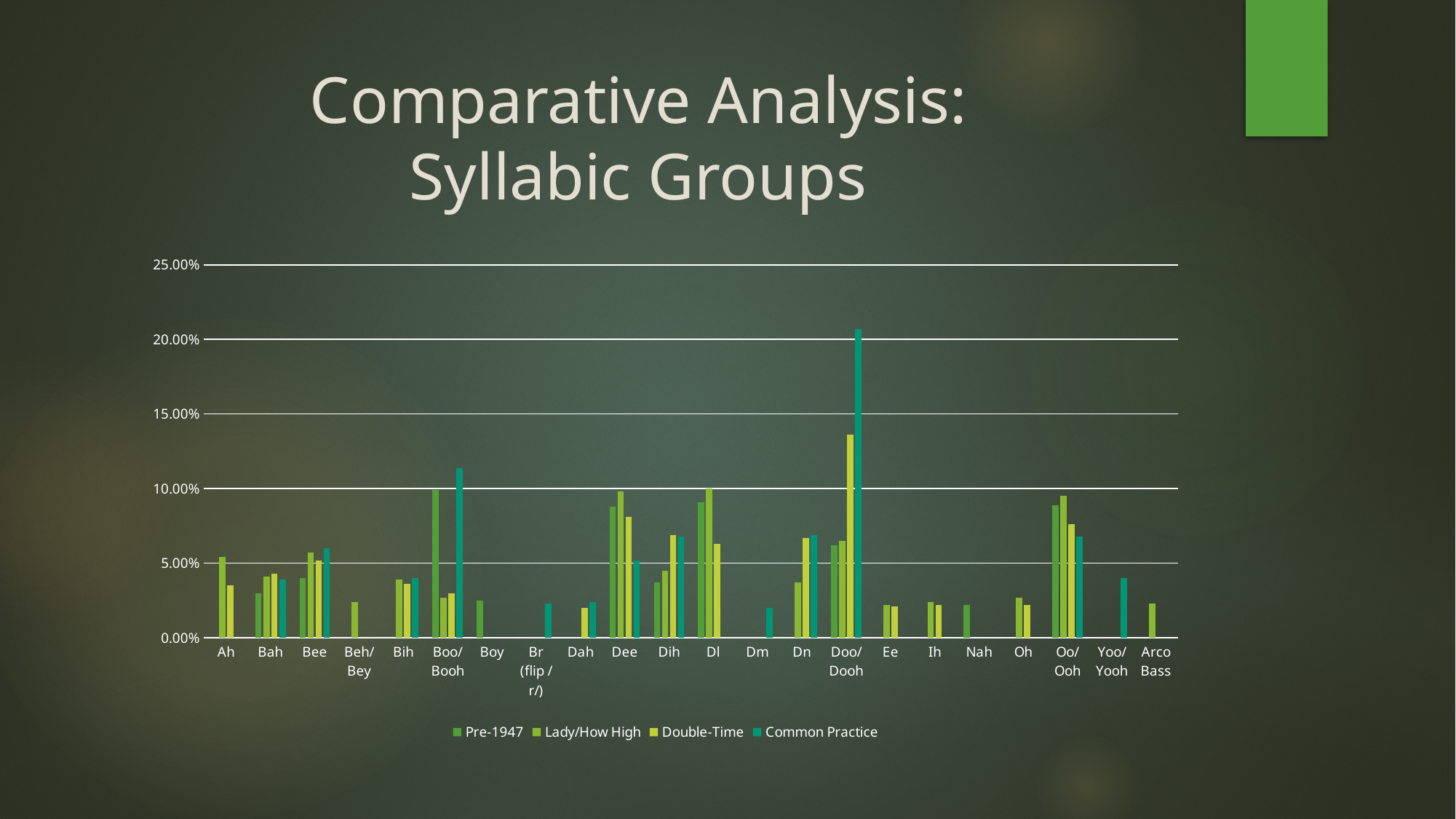
How many series does the legend list? 4 Is the Common Practice value for Boo/Booh greater or less than 10.00%? greater Is the Common Practice value for Doo/Dooh greater or less than 20.00%? greater What kind of chart is shown on the slide? bar chart What is the title of the chart's slide? Comparative Analysis: Syllabic Groups Which category has the tallest bar in the chart? Doo/Dooh How many syllabic group categories are shown on the x axis? 22 Which series has the highest value for Doo/Dooh? Common Practice For Boo/Booh, which is larger: the Pre-1947 value or the Common Practice value? Common Practice For Dee, which is larger: the Lady/How High value or the Double-Time value? Lady/How High Is the Double-Time value for Doo/Dooh greater or less than 10.00%? greater